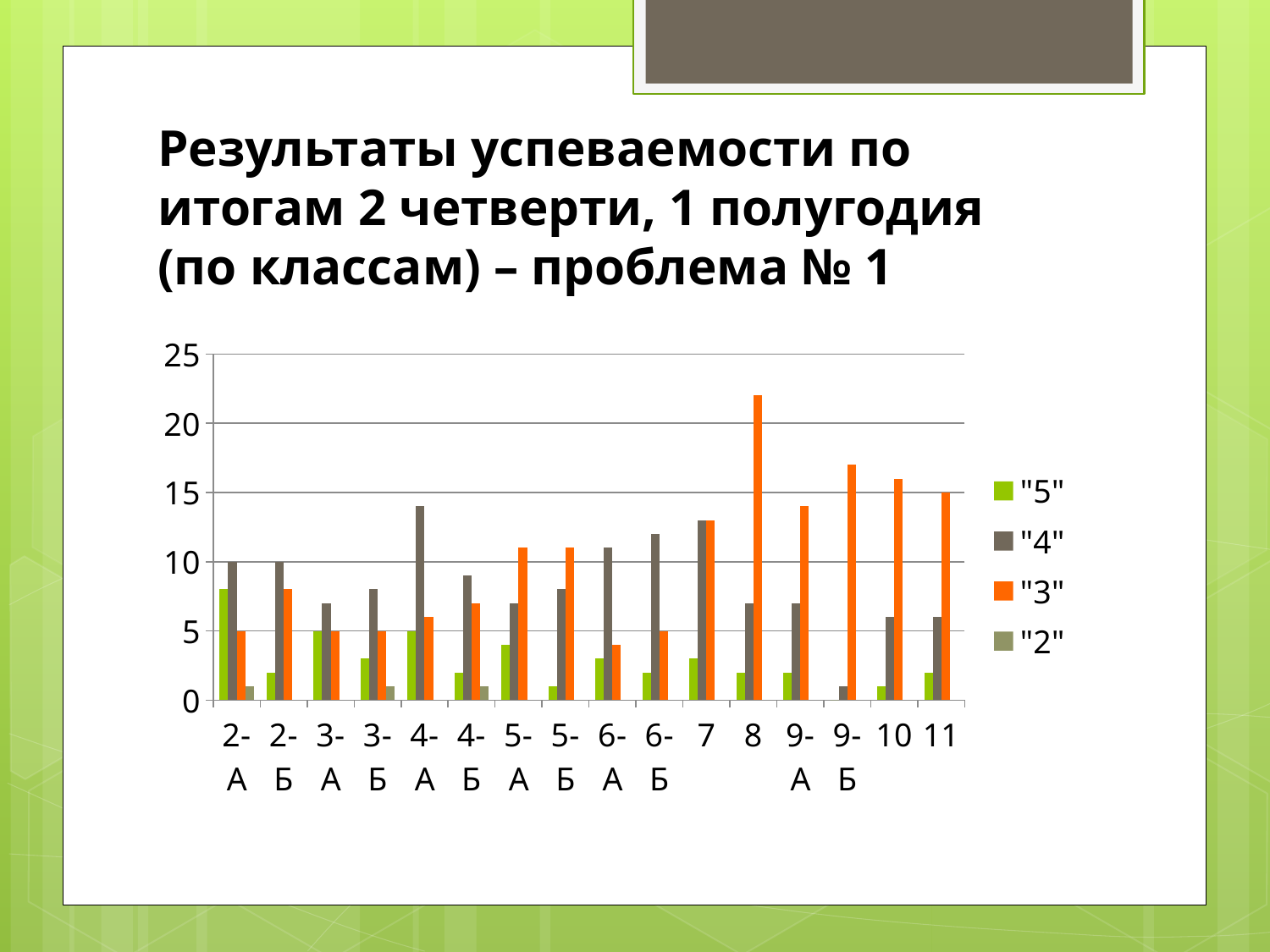
How many series does the legend list? 4 How many class categories are shown on the x axis? 16 What kind of chart is shown on the slide? bar chart Which class has the highest value for the "3" series? 8 Which class has the larger value for the "3" series: 8 or 9-А? 8 What are the four legend entries of the chart? "5", "4", "3", "2" Is the value of the "3" series for class 9-Б greater or less than 15? greater Is the value of the "5" series for class 2-А greater or less than 5? greater Is the value of the "3" series for class 8 greater or less than 20? greater What is the value of the "4" series for class 2-А? 10 Which is larger for class 2-А: the "4" series or the "3" series? "4"